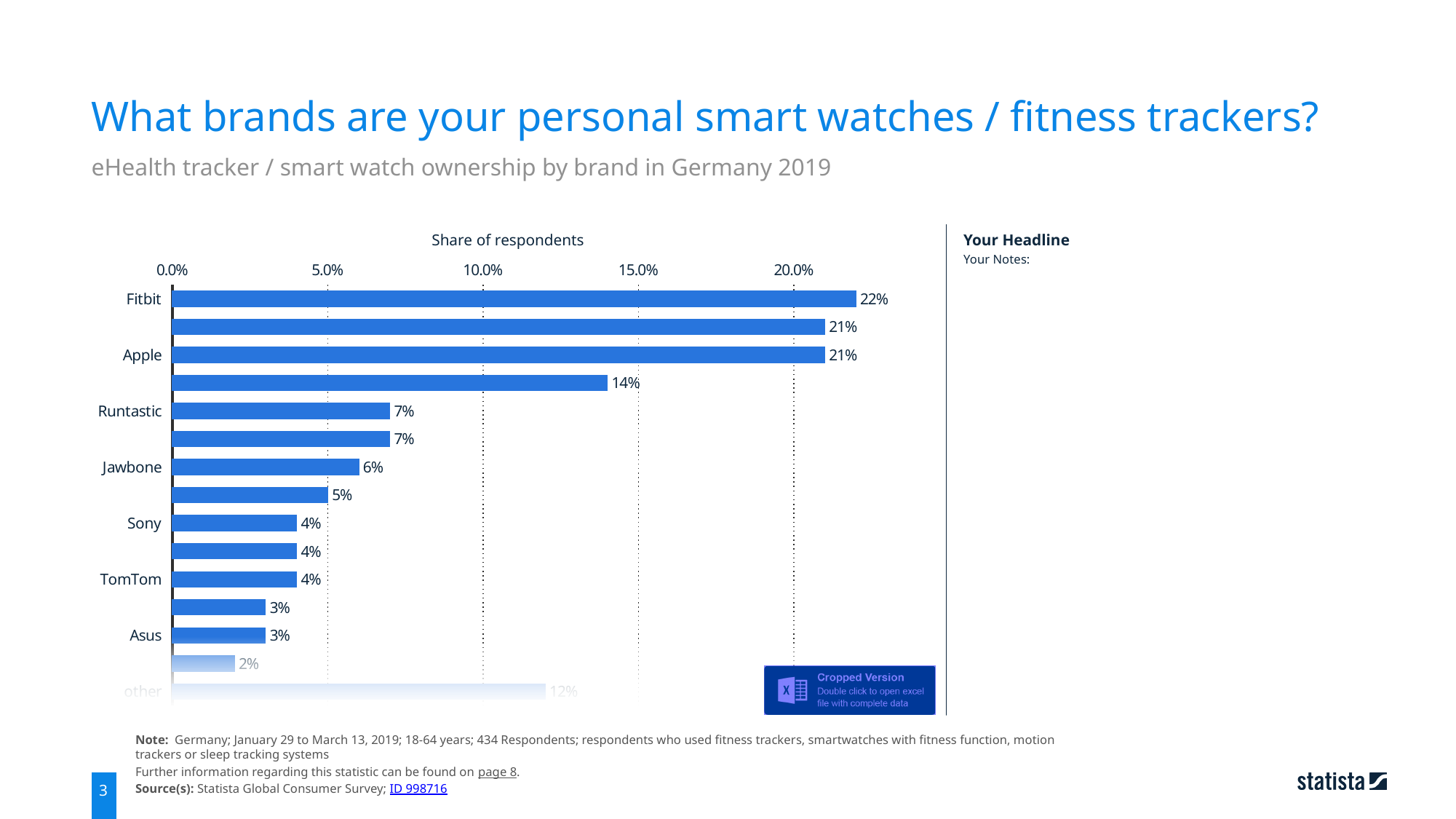
What kind of chart is shown on the slide? bar chart What is the title shown above the chart's axis? Share of respondents What share of respondents is shown for Runtastic? 7% What is the value for Jawbone? 6% Is the value for Fitbit greater or less than 20.0%? greater What is the difference between the values for Fitbit and Apple? 1% Which brand has the highest share of respondents? Fitbit What share of respondents is shown for TomTom? 4% Which has a larger value, Runtastic or Jawbone? Runtastic What is the value for Asus? 3% What is the value shown for Apple? 21% What share of respondents own a Fitbit smart watch / fitness tracker? 22%